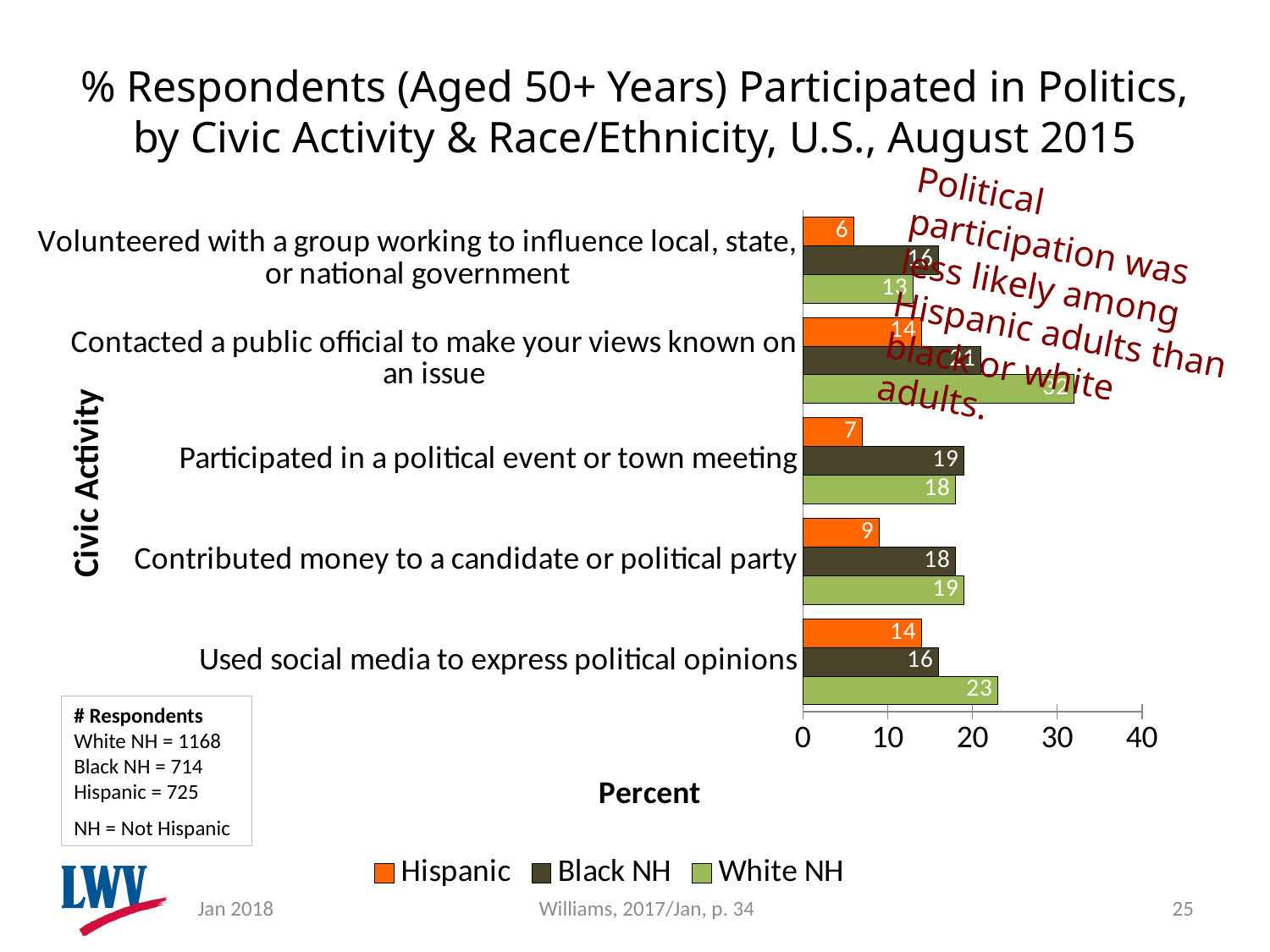
What kind of chart is shown on the slide? bar chart What is the value for Hispanic respondents who volunteered with a group working to influence local, state, or national government? 6 Which colour represents the Hispanic series in the legend? orange What is the value for White NH respondents who used social media to express political opinions? 23 How many series does the legend list? 3 Which civic activity has the lowest value for Hispanic respondents? Volunteered with a group working to influence local, state, or national government What is the difference between the White NH and Hispanic values for using social media to express political opinions? 9 How many civic activities are plotted on the chart? 5 For contributing money to a candidate or political party, which is larger: the Hispanic value or the Black NH value? Black NH Is the White NH value for contacting a public official to make your views known on an issue greater or less than 30? greater What is the value for Black NH respondents who participated in a political event or town meeting? 19 What is the value for Hispanic respondents who used social media to express political opinions? 14